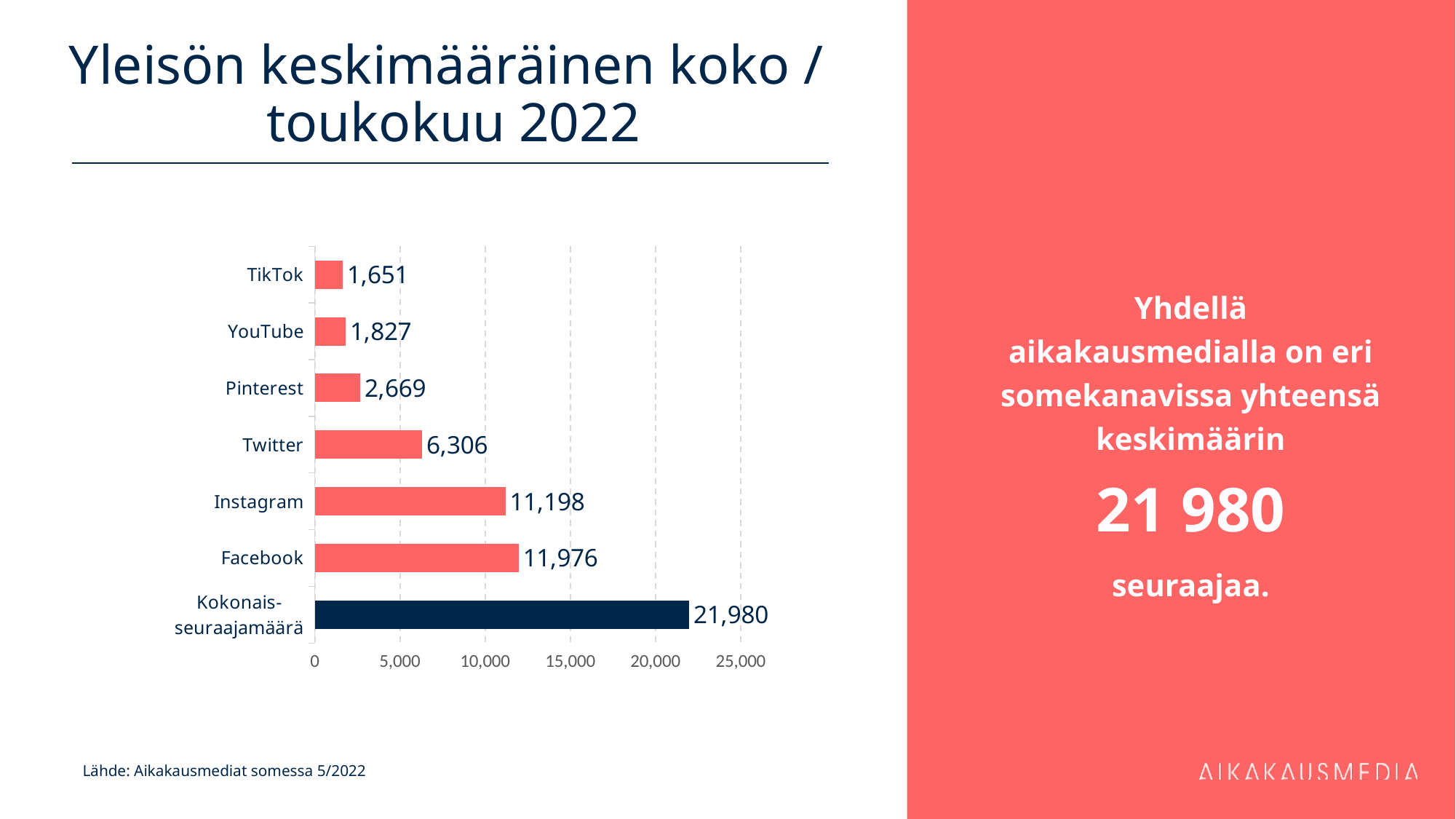
Which category has the lowest value? TikTok What kind of chart is shown on the slide? bar chart Is the value for Twitter greater or less than 5,000? greater What is the difference between the values for YouTube and TikTok? 176 What is the value for Kokonais-seuraajamäärä? 21,980 Which is larger, the value for Pinterest or the value for YouTube? Pinterest What is the difference between the values for Facebook and Instagram? 778 What is the value for Twitter? 6,306 What is the value for TikTok? 1,651 Which category has the highest value? Kokonais-seuraajamäärä What is the value for Facebook? 11,976 How many categories are shown in the chart? 7